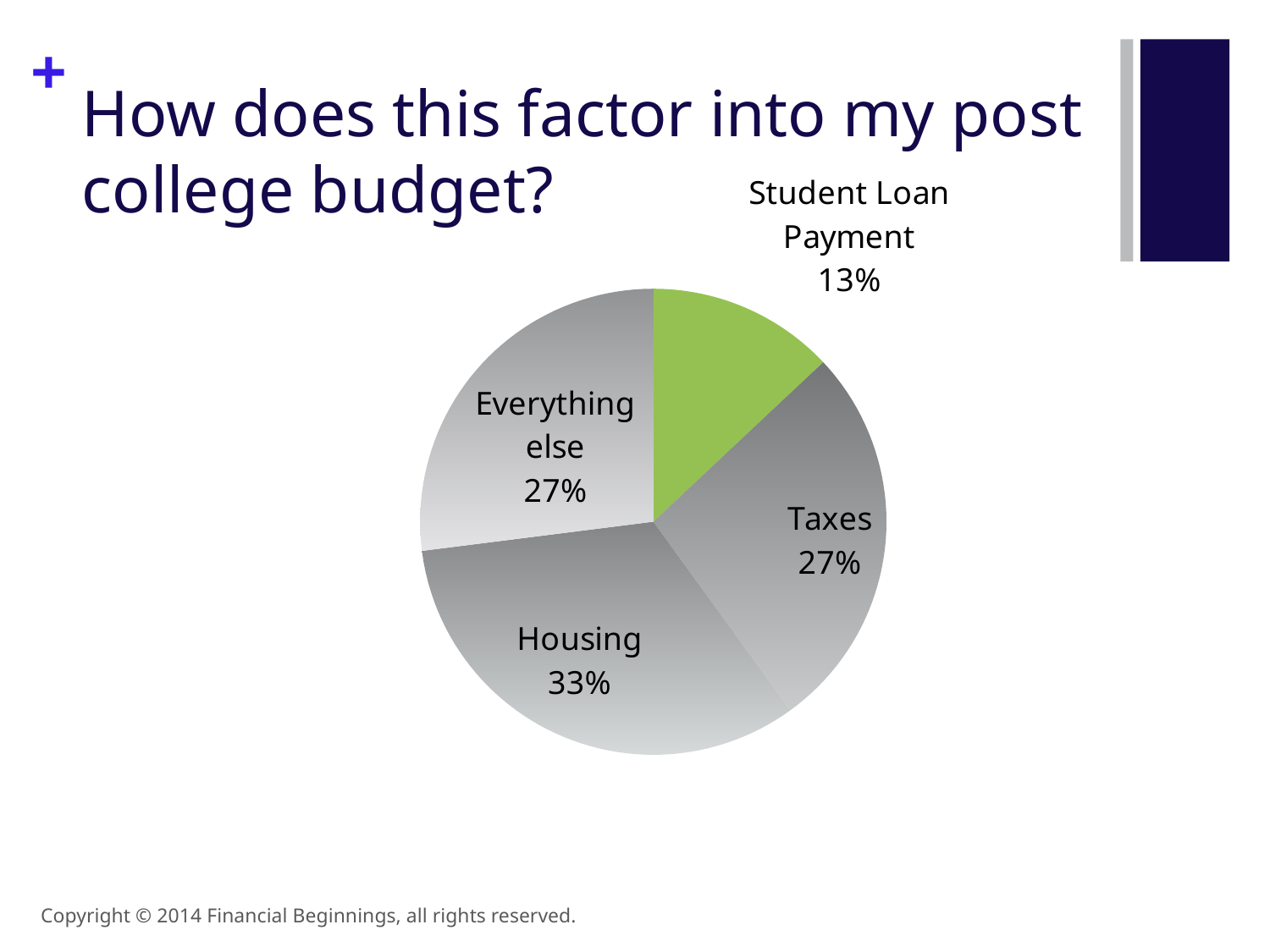
How many slices does the pie chart have? 4 What is the difference in percentage points between Taxes and Student Loan Payment? 14 What is the value shown for Student Loan Payment? 13% What share of the pie does Housing take? 33% What percentage is shown for Taxes? 27% What is the difference in percentage points between Housing and Student Loan Payment? 20 Which category has the smallest slice of the pie? Student Loan Payment What percentage is shown for Everything else? 27% What kind of chart is shown on the slide? Pie chart Which is larger, the slice for Housing or the slice for Taxes? Housing Which category has the largest slice of the pie? Housing Which slice of the pie is coloured green? Student Loan Payment